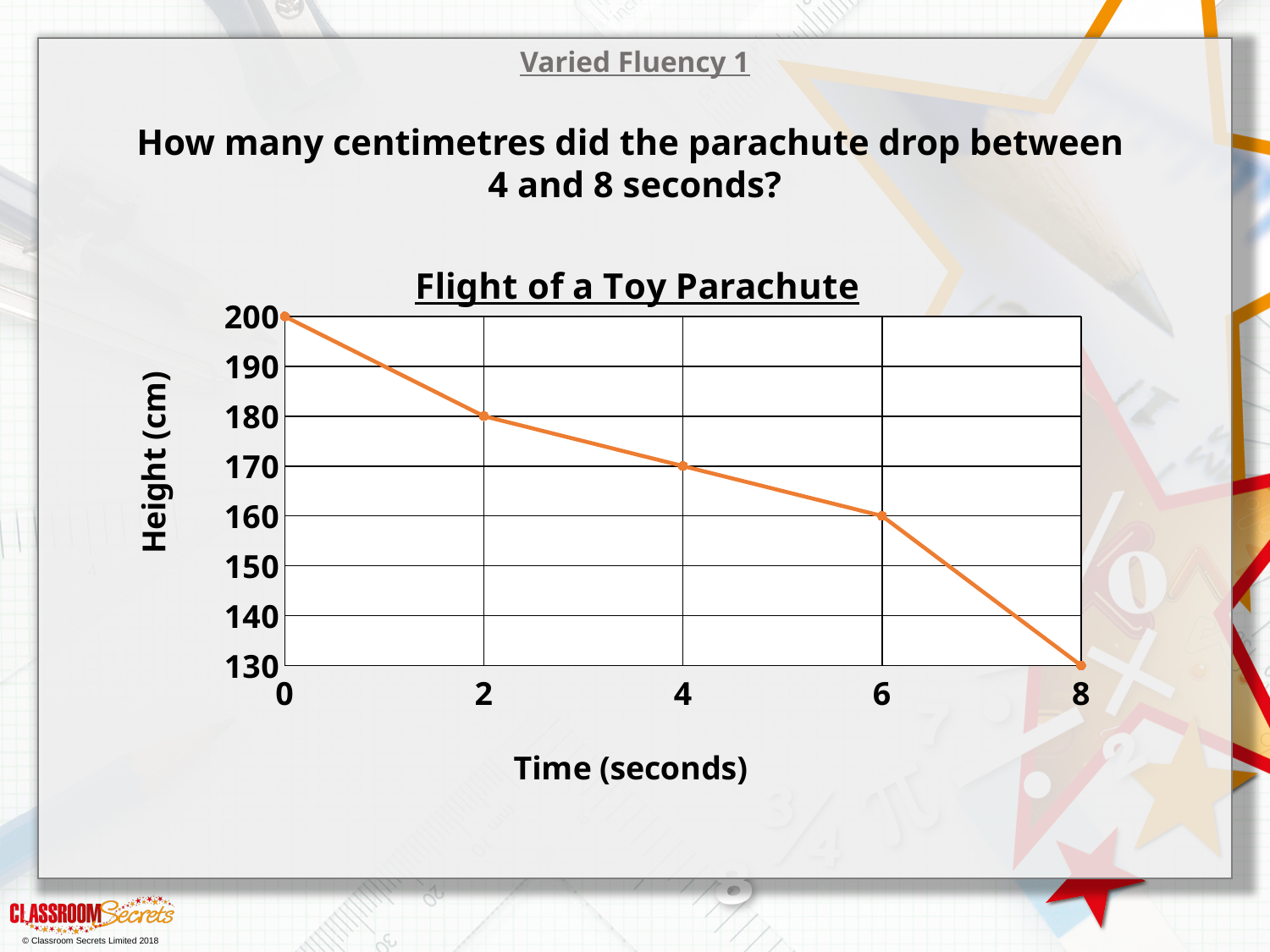
At which time is the parachute's height highest? 0 What is the difference in height between 0 seconds and 2 seconds? 20 What is the height of the parachute at 2 seconds? 180 Does the height rise or fall as time increases along the x axis? fall What is the height of the parachute at 0 seconds? 200 What is the height of the parachute at 4 seconds? 170 What is the height of the parachute at 8 seconds? 130 At which time is the parachute's height lowest? 8 What is the title of the chart? Flight of a Toy Parachute Is the height at 6 seconds greater or less than the height at 2 seconds? less How many centimetres did the parachute drop between 4 and 8 seconds? 40 What type of chart is shown on the slide? line chart